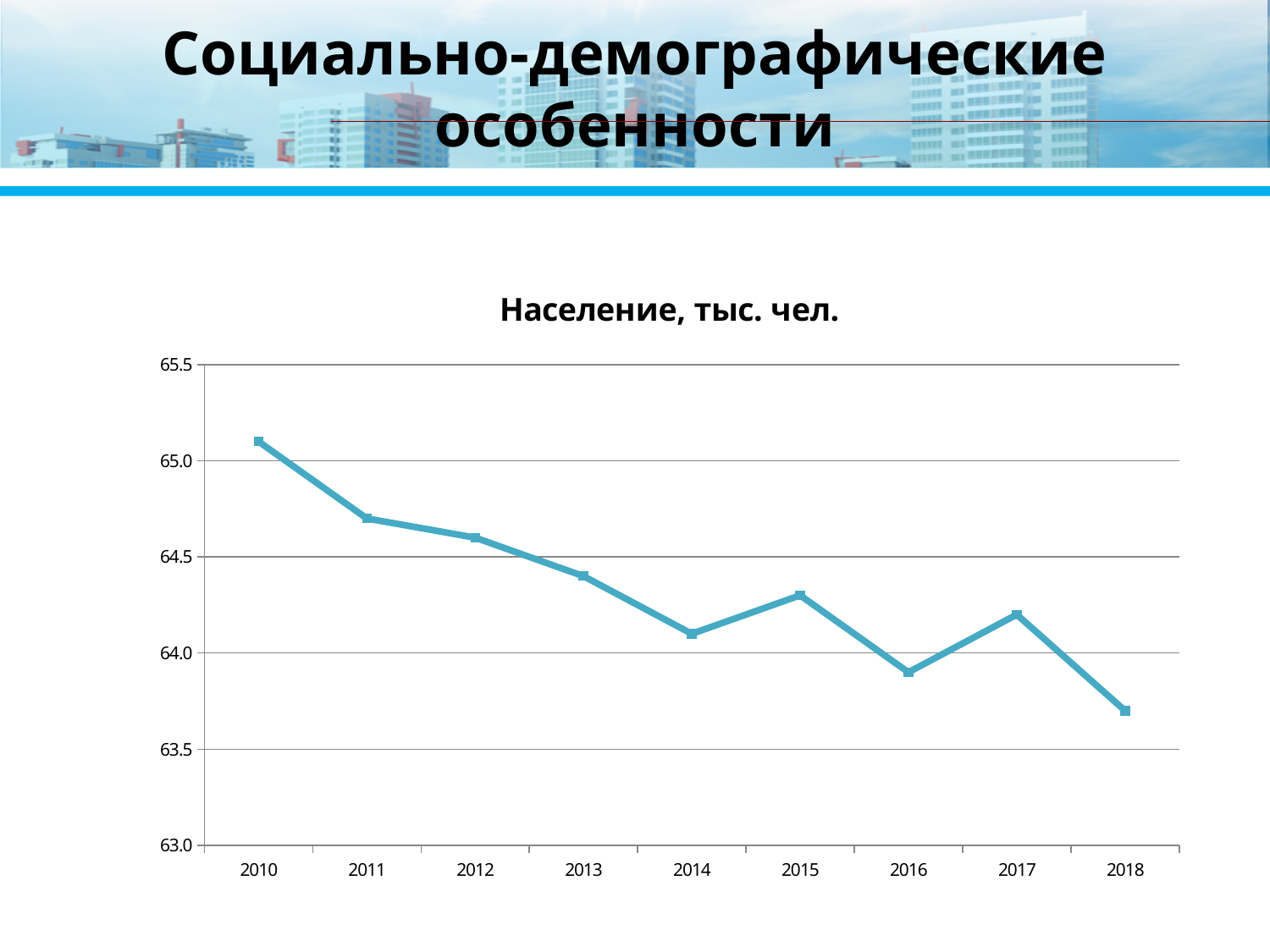
Which year has the highest population value on the chart? 2010 What is the title of the chart? Население, тыс. чел. Is the value for 2010 greater or less than 65.0? greater Is the value for 2018 greater or less than 63.5? greater What kind of chart is shown on the slide? line chart Which year has the larger population value, 2011 or 2017? 2011 Overall, do the population values rise or fall from 2010 to 2018? fall How many years are plotted on the x axis of the chart? 9 Is the value for 2016 greater or less than 64.0? less Which year has the larger population value, 2015 or 2016? 2015 Which year has the lowest population value on the chart? 2018